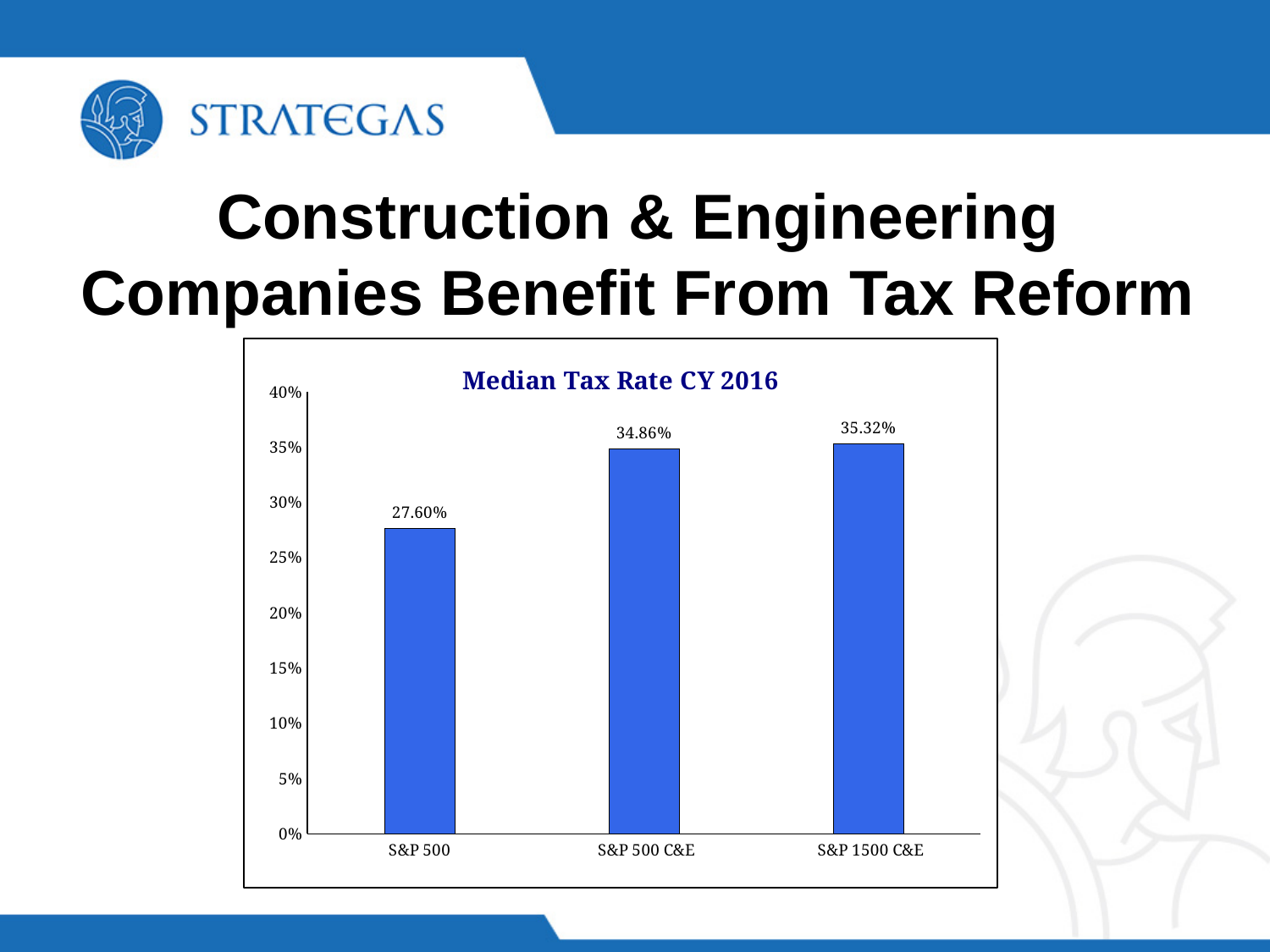
Is the median tax rate for S&P 500 greater or less than 30%? less What is the difference between the median tax rate for S&P 1500 C&E and S&P 500? 7.72% Which category has the highest median tax rate? S&P 1500 C&E What is the difference between the median tax rate for S&P 500 C&E and S&P 500? 7.26% What is the median tax rate for S&P 500 C&E? 34.86% What is the title of the chart? Median Tax Rate CY 2016 Which is larger, the median tax rate for S&P 500 or for S&P 500 C&E? S&P 500 C&E Which category has the lowest median tax rate? S&P 500 What kind of chart is shown on the slide? bar chart What is the median tax rate for S&P 1500 C&E? 35.32% How many categories are shown in the chart? 3 What is the median tax rate for S&P 500? 27.60%